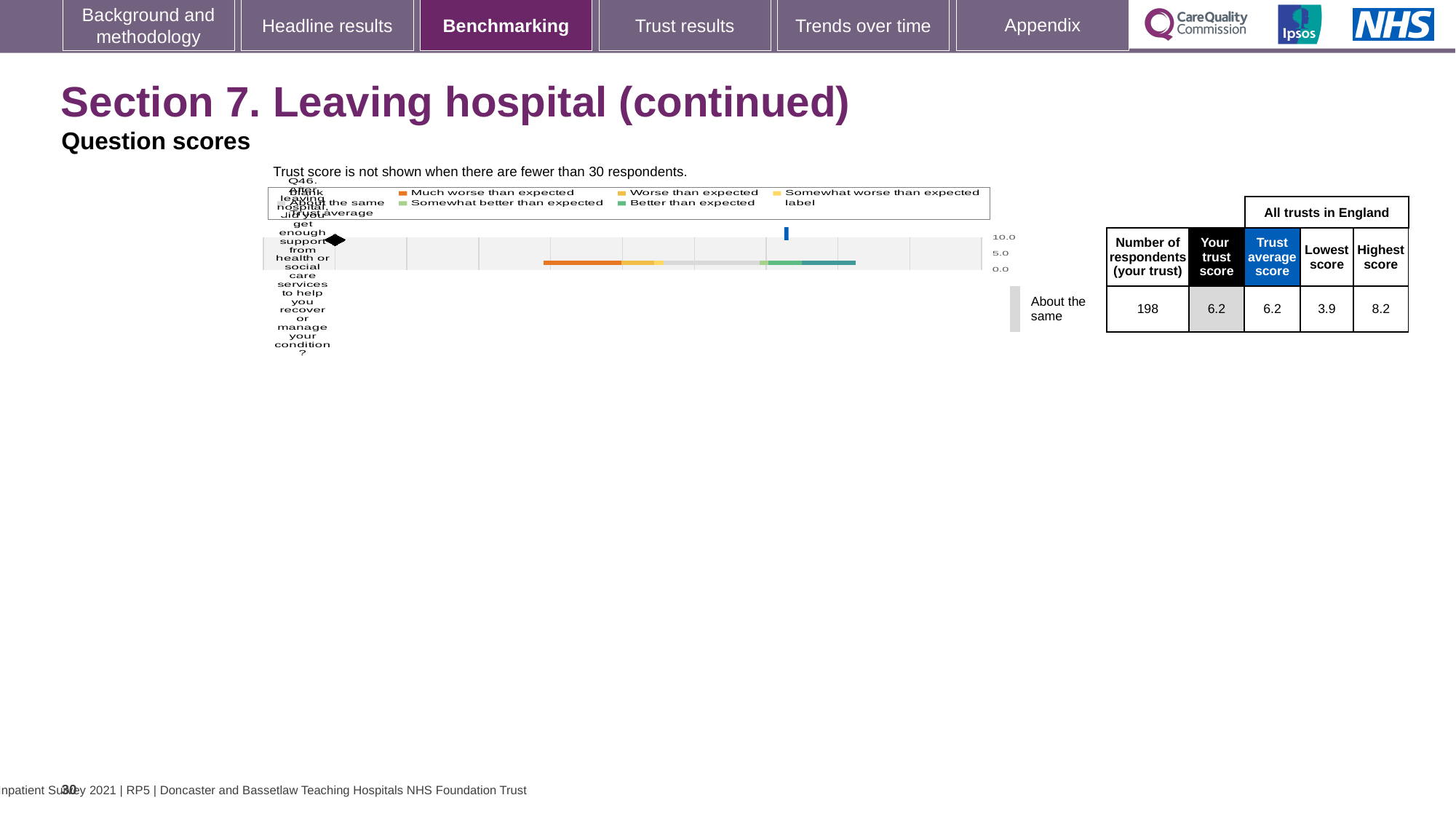
What is the highest tick value shown on the chart's score axis? 10.0 What kind of chart is shown on the slide? bar chart What is the difference between the highest and lowest scores for Q46 across all trusts in England? 4.3 What is the trust score for Q46 shown in the table beside the chart? 6.2 What is the lowest score across all trusts in England for Q46? 3.9 How many respondents from the trust answered Q46? 198 How many questions are plotted in the chart? 1 Which legend entry is shown in orange? Much worse than expected What is the trust average score for Q46 shown in the table beside the chart? 6.2 Is the trust score for Q46 greater or less than 5.0? greater What is the highest score across all trusts in England for Q46? 8.2 Which benchmark category is the trust's Q46 score placed in? About the same